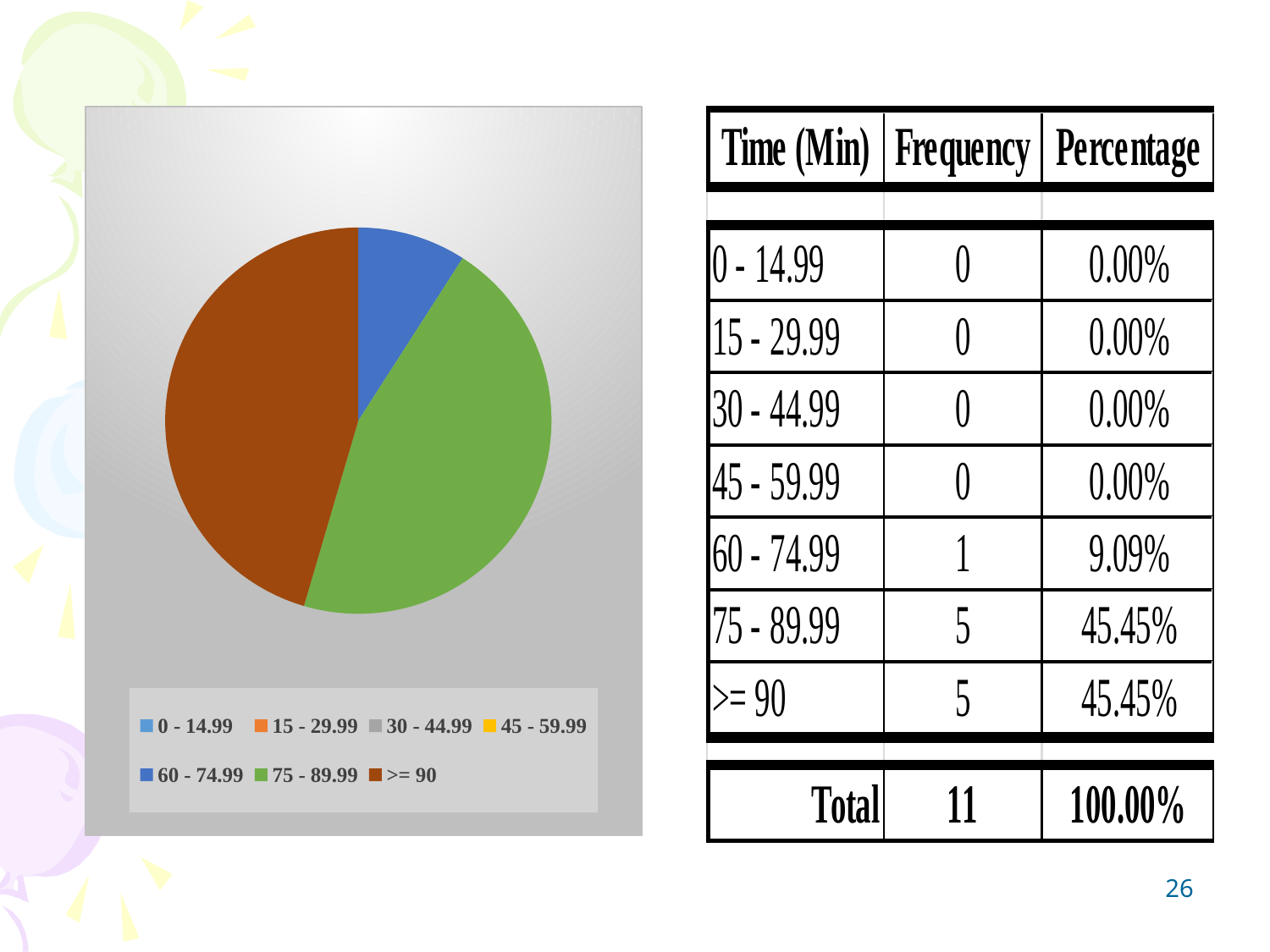
According to the table, what share of the pie does the 60 - 74.99 slice represent? 9.09% What is the difference in frequency between the 75 - 89.99 category and the 60 - 74.99 category? 4 Which is larger in the pie chart, the slice for 75 - 89.99 or the slice for 60 - 74.99? 75 - 89.99 What is the frequency for the 75 - 89.99 category in the table? 5 What colour is the >= 90 slice in the pie chart? brown What is the total frequency shown in the table? 11 How many categories does the pie chart's legend list? 7 What kind of chart is shown on the left of the slide? pie chart According to the table, what share of the pie does the >= 90 slice represent? 45.45% Which legend entry in the pie chart is shown in blue? 60 - 74.99 Which visible slice of the pie chart is the smallest? 60 - 74.99 How many slices are visible in the pie chart? 3